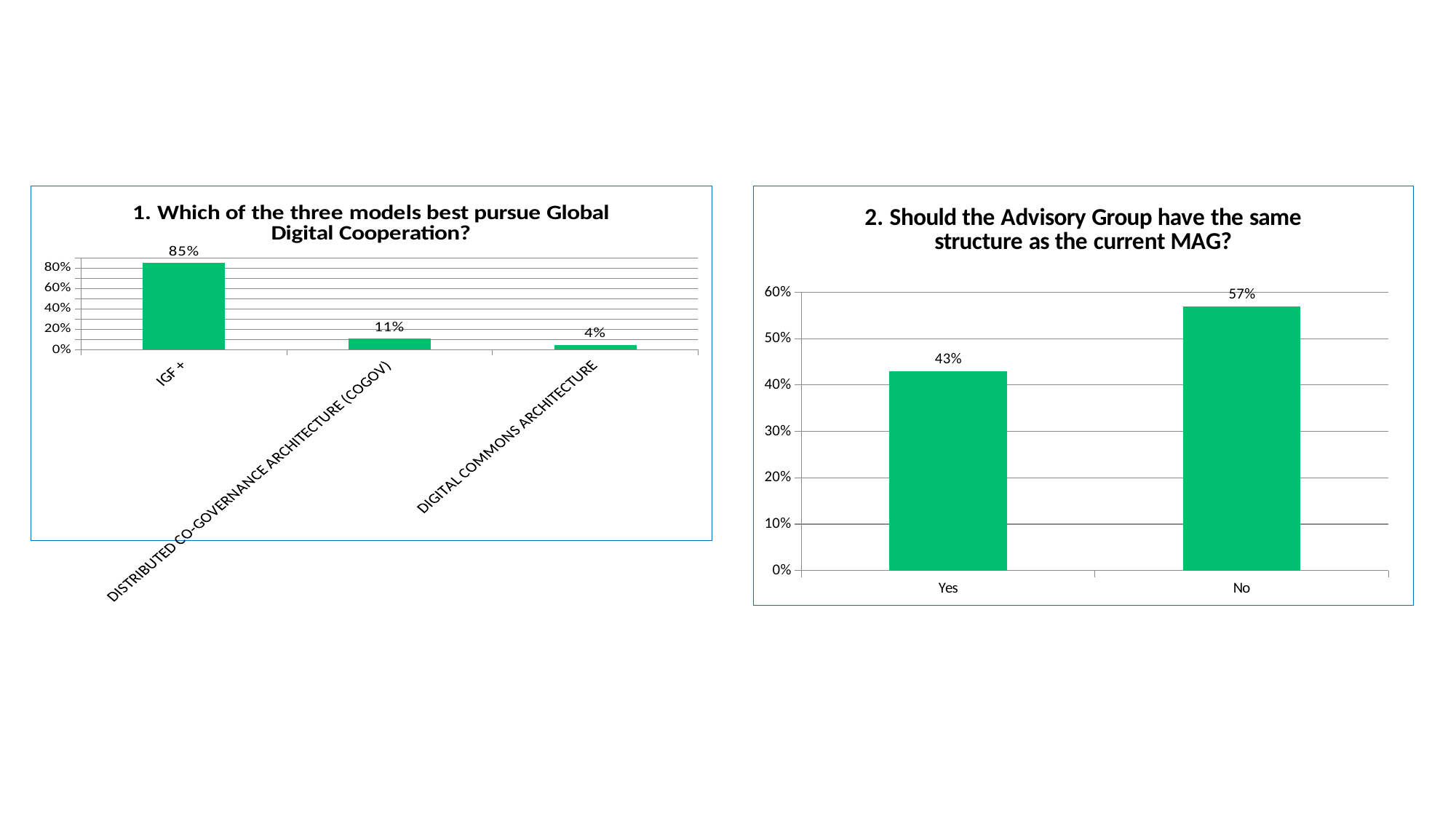
In the left chart titled "1. Which of the three models best pursue Global Digital Cooperation?", what is the value for IGF +? 85% What kind of chart is the right chart titled "2. Should the Advisory Group have the same structure as the current MAG?"? Bar chart In the right chart titled "2. Should the Advisory Group have the same structure as the current MAG?", which is larger, Yes or No? No In the right chart titled "2. Should the Advisory Group have the same structure as the current MAG?", what is the difference between the values for No and Yes? 14% In the left chart titled "1. Which of the three models best pursue Global Digital Cooperation?", how many categories are shown? 3 In the left chart titled "1. Which of the three models best pursue Global Digital Cooperation?", which category has the lowest value? DIGITAL COMMONS ARCHITECTURE In the left chart titled "1. Which of the three models best pursue Global Digital Cooperation?", what is the value for DISTRIBUTED CO-GOVERNANCE ARCHITECTURE (COGOV)? 11% In the left chart titled "1. Which of the three models best pursue Global Digital Cooperation?", which category has the highest value? IGF + In the left chart titled "1. Which of the three models best pursue Global Digital Cooperation?", what is the difference between the values for IGF + and DISTRIBUTED CO-GOVERNANCE ARCHITECTURE (COGOV)? 74% In the right chart titled "2. Should the Advisory Group have the same structure as the current MAG?", what is the value for Yes? 43% In the right chart titled "2. Should the Advisory Group have the same structure as the current MAG?", what is the value for No? 57% In the left chart titled "1. Which of the three models best pursue Global Digital Cooperation?", what is the value for DIGITAL COMMONS ARCHITECTURE? 4%